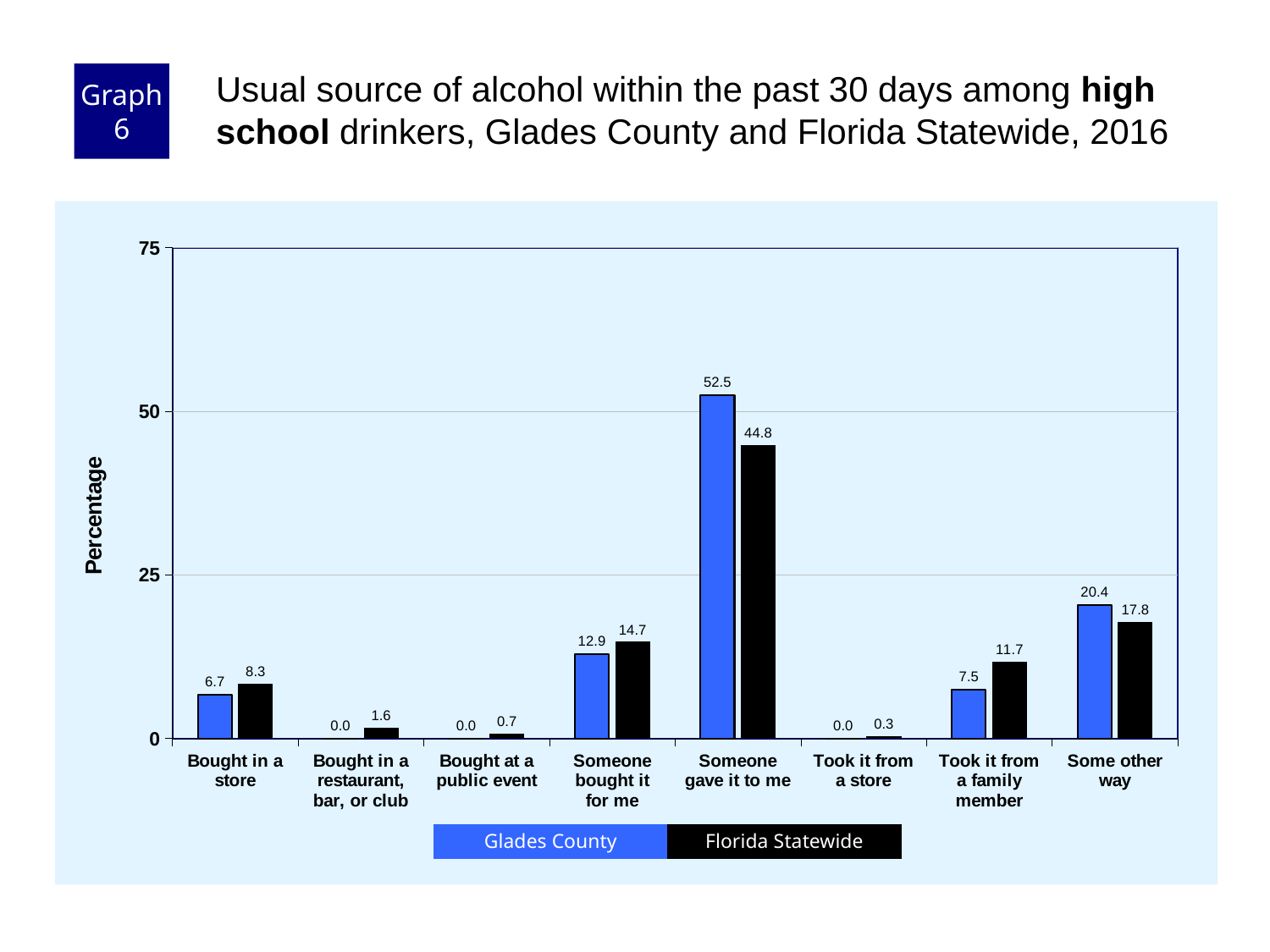
Which category has the highest Florida Statewide value? Someone gave it to me How many series does the legend list? 2 Which is larger for "Bought in a store": Glades County or Florida Statewide? Florida Statewide How many categories are shown on the x axis? 8 Which category has the lowest Florida Statewide value? Took it from a store What kind of chart is shown on the slide? bar chart What is the difference between the Florida Statewide and Glades County values for "Took it from a family member"? 4.2 What is the Glades County value for "Someone gave it to me"? 52.5 What is the Florida Statewide value for "Took it from a family member"? 11.7 What is the difference between the Glades County and Florida Statewide values for "Someone gave it to me"? 7.7 What is the Glades County value for "Some other way"? 20.4 Is the Glades County value for "Someone gave it to me" greater or less than 50? greater